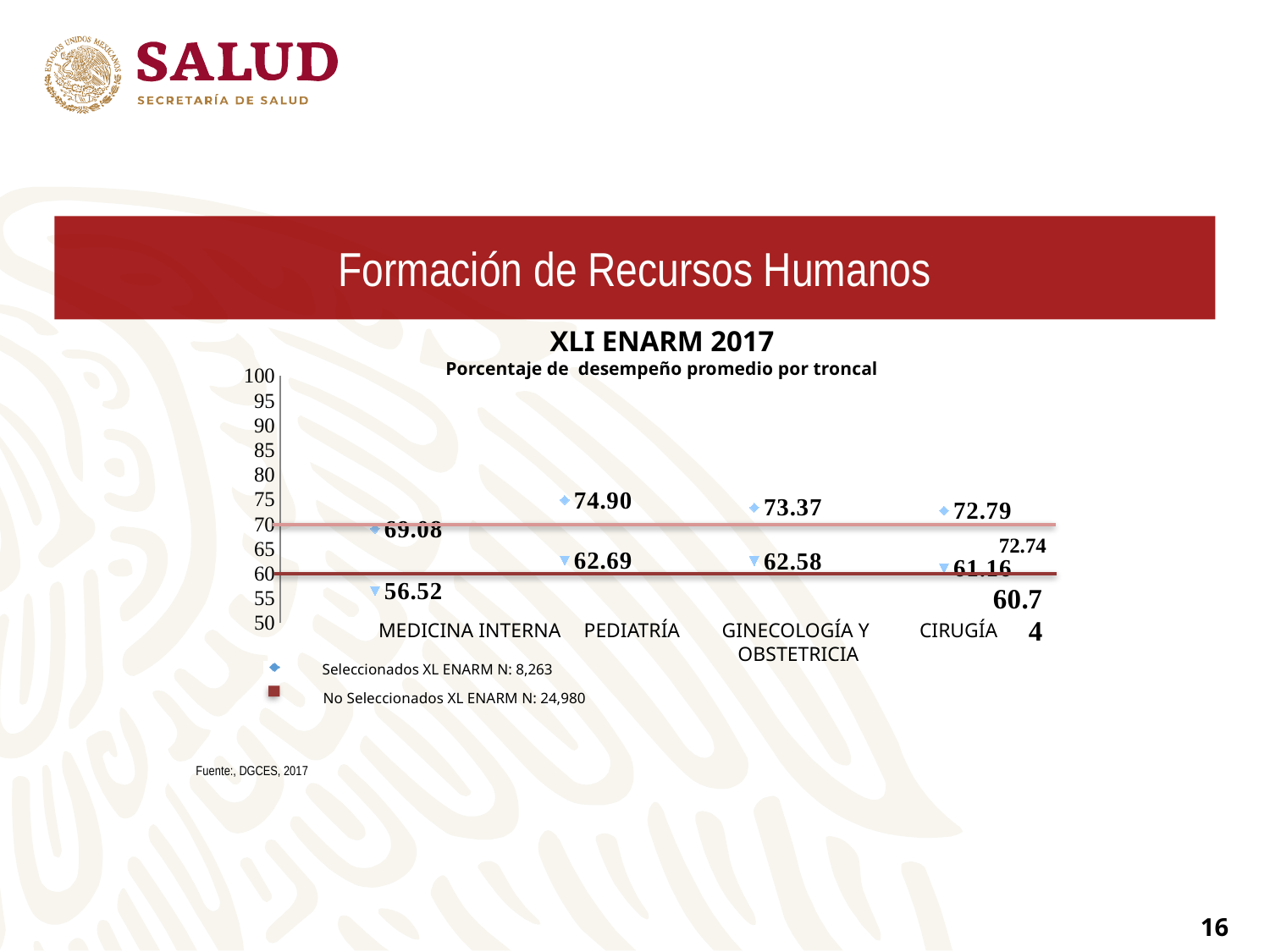
Which troncal has the highest Seleccionados value? PEDIATRÍA Which troncal has the lowest No Seleccionados value? MEDICINA INTERNA What is the difference between the Seleccionados and No Seleccionados values for PEDIATRÍA? 12.21 How many troncales (categories) are shown on the x axis? 4 What is the title of the chart? XLI ENARM 2017 Porcentaje de desempeño promedio por troncal Which troncal has the lowest Seleccionados value? MEDICINA INTERNA What is the Seleccionados value for GINECOLOGÍA Y OBSTETRICIA? 73.37 What is the difference between the Seleccionados and No Seleccionados values for MEDICINA INTERNA? 12.56 What is the Seleccionados value for PEDIATRÍA? 74.90 What is the No Seleccionados value for CIRUGÍA? 61.16 For CIRUGÍA, which is larger: the Seleccionados value or the No Seleccionados value? Seleccionados What is the No Seleccionados value for MEDICINA INTERNA? 56.52